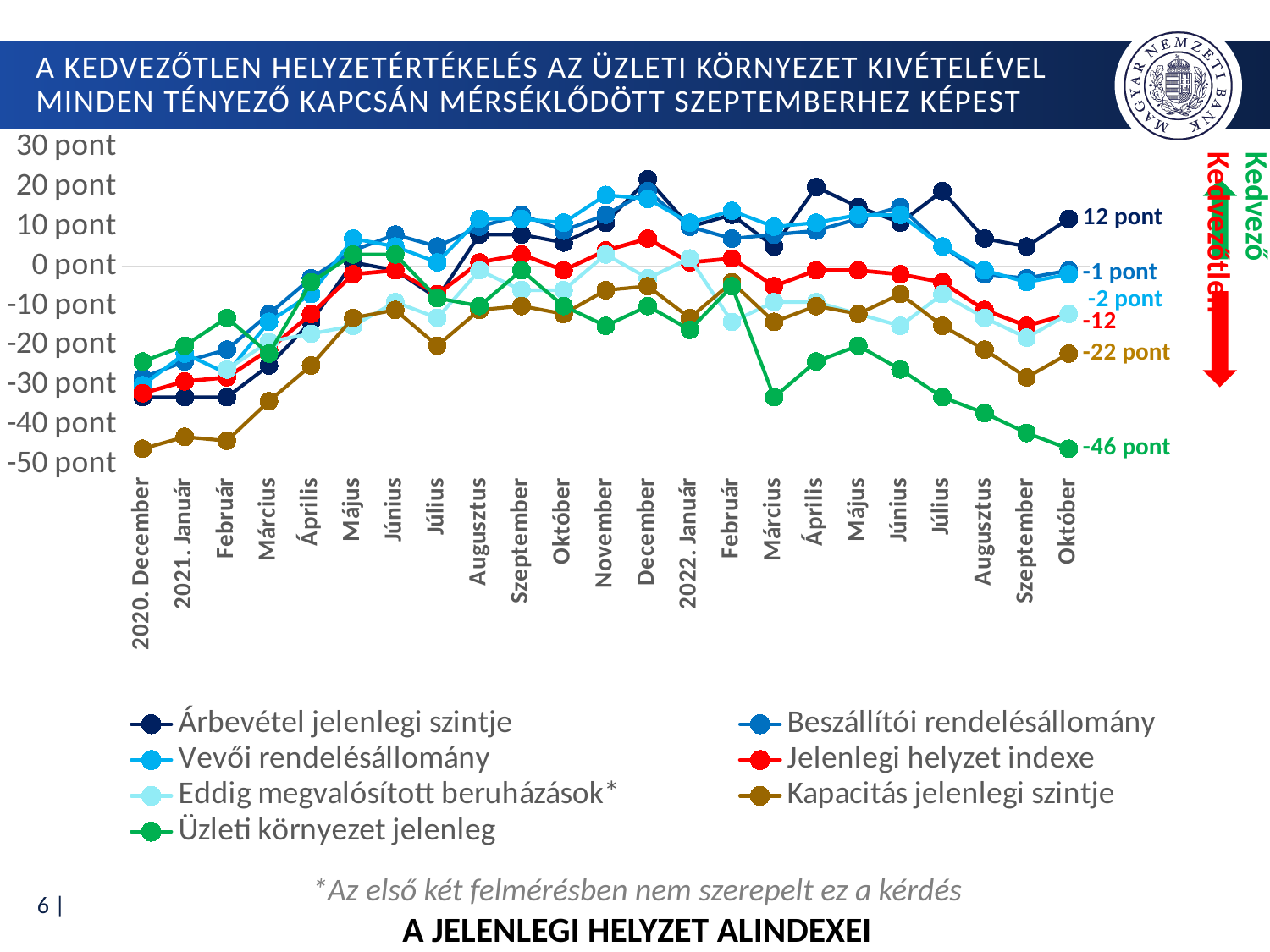
How many months are shown on the x axis? 23 What kind of chart is shown on the slide? line chart Which series has the lowest value in 2022 Október? Üzleti környezet jelenleg What is the difference between Árbevétel jelenlegi szintje and Üzleti környezet jelenleg in 2022 Október? 58 pont What is the value of Üzleti környezet jelenleg in 2022 Október? -46 pont Does Üzleti környezet jelenleg rise or fall from 2022 Február to 2022 Október? fall How many series does the legend list? 7 Which series has the highest value in 2022 Október? Árbevétel jelenlegi szintje What is the value of Árbevétel jelenlegi szintje in 2022 Október? 12 pont Is the value for Kapacitás jelenlegi szintje in 2020 December greater or less than -40 pont? less What is the value of Kapacitás jelenlegi szintje in 2022 Október? -22 pont What is the value of Beszállítói rendelésállomány in 2022 Október? -1 pont